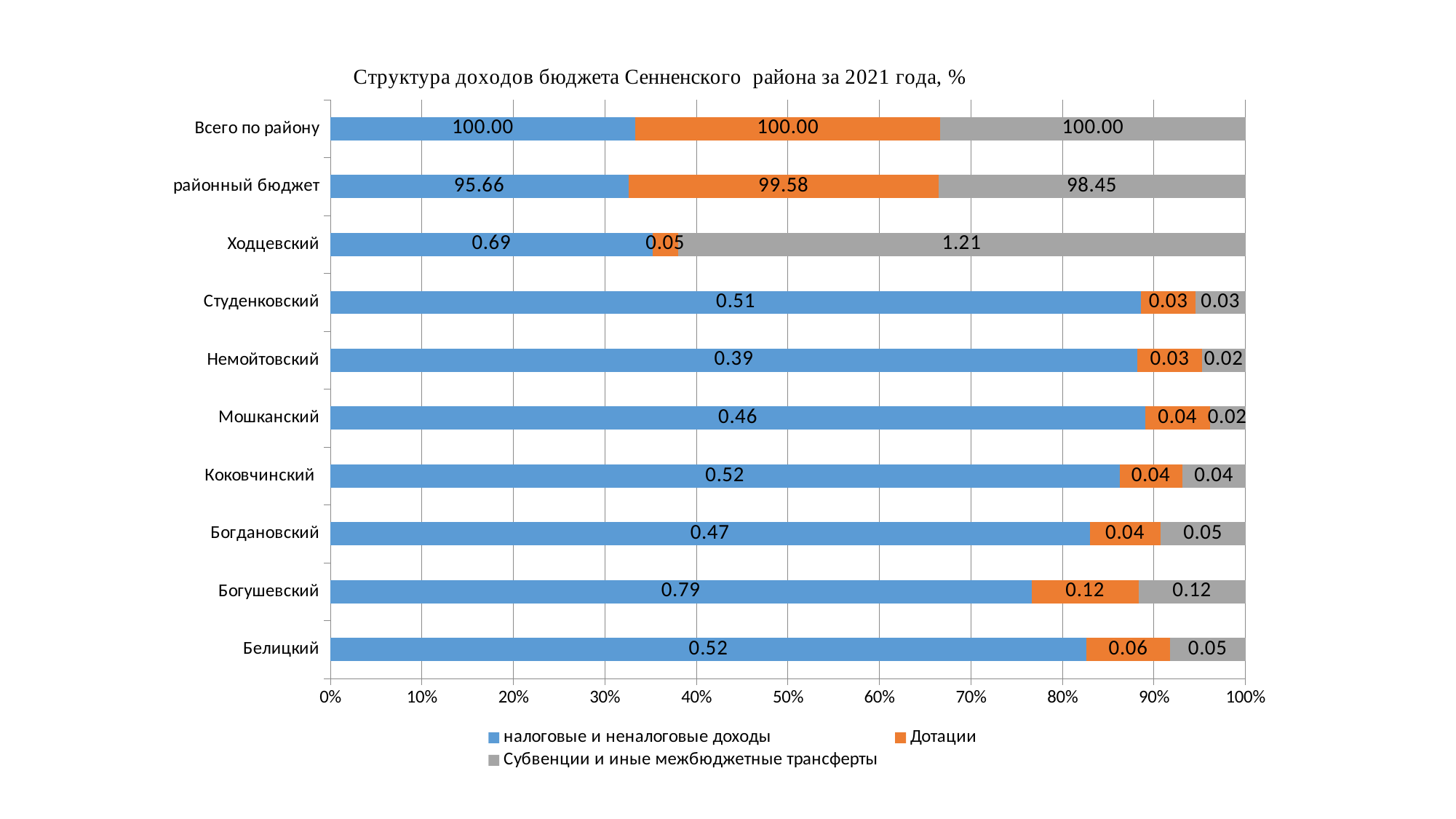
What is the value of 'Субвенции и иные межбюджетные трансферты' for Ходцевский? 1.21 How many categories are shown on the vertical axis? 10 What is the title of the chart? Структура доходов бюджета Сенненского района за 2021 года, % How many series does the legend list? 3 What is the value of 'налоговые и неналоговые доходы' for Богушевский? 0.79 What is the value of 'Дотации' for Белицкий? 0.06 Which category has the lowest value for 'налоговые и неналоговые доходы'? Немойтовский For районный бюджет, what is the difference between the 'Дотации' value and the 'Субвенции и иные межбюджетные трансферты' value? 1.13 Which is larger: the 'Субвенции и иные межбюджетные трансферты' value for Ходцевский or for Богушевский? Ходцевский What is the value of 'Дотации' for районный бюджет? 99.58 What kind of chart is shown on the slide? Bar chart What is the difference between the 'налоговые и неналоговые доходы' values for Богушевский and Ходцевский? 0.10